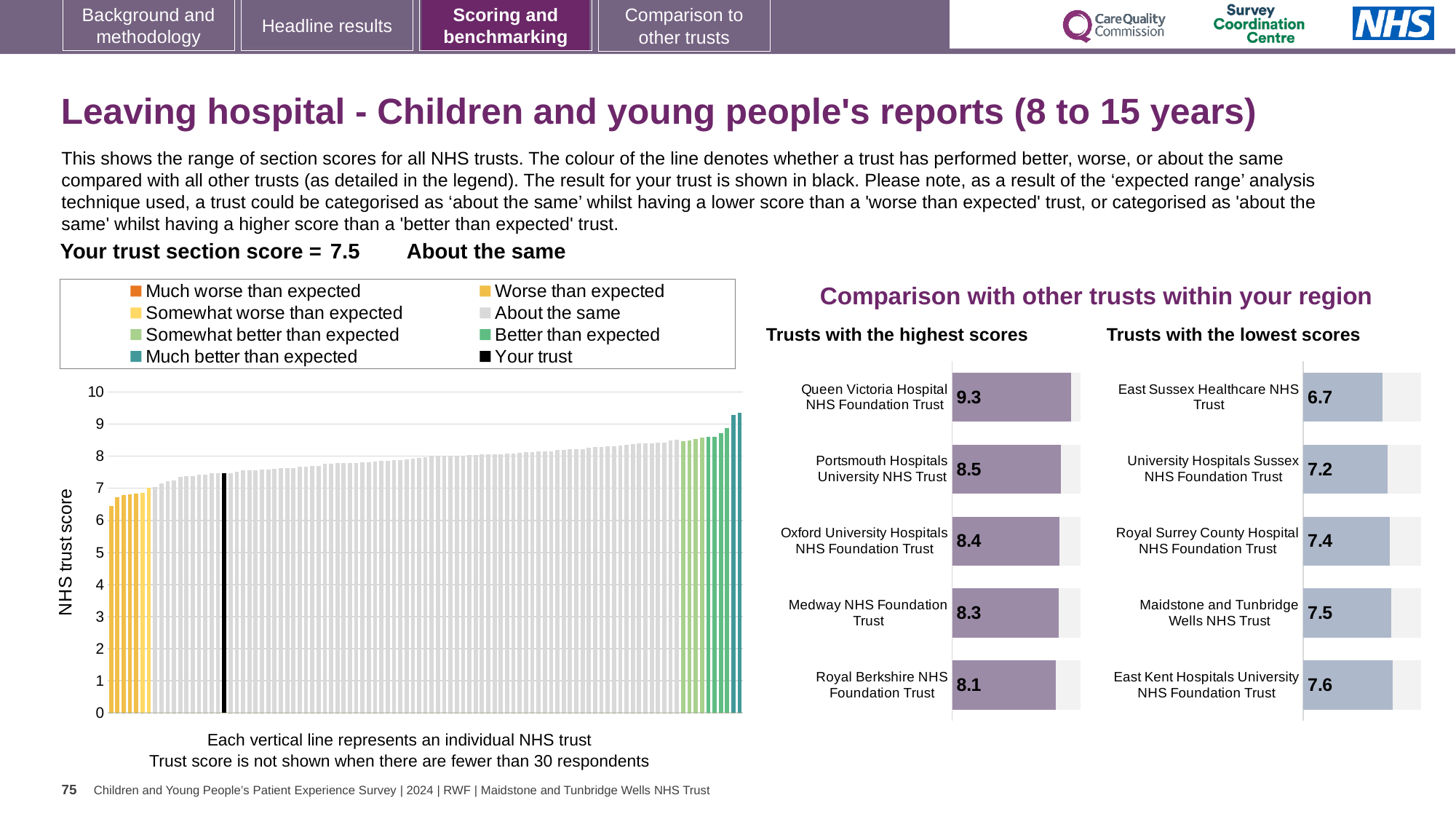
How many trusts are listed in the 'Trusts with the highest scores' chart? 5 In the 'Trusts with the lowest scores' chart, what is the difference between the scores of East Kent Hospitals University NHS Foundation Trust and East Sussex Healthcare NHS Trust? 0.9 In the NHS trust score chart on the left, is the value of the tallest bar greater or less than 9? greater In the 'Trusts with the lowest scores' chart, which trust has the lowest score? East Sussex Healthcare NHS Trust In the 'Trusts with the lowest scores' chart, which has the higher score: Royal Surrey County Hospital NHS Foundation Trust or Maidstone and Tunbridge Wells NHS Trust? Maidstone and Tunbridge Wells NHS Trust In the 'Trusts with the highest scores' chart, what is the score for Medway NHS Foundation Trust? 8.3 In the 'Trusts with the lowest scores' chart, what is the score for University Hospitals Sussex NHS Foundation Trust? 7.2 In the 'Trusts with the highest scores' chart, which trust has the highest score? Queen Victoria Hospital NHS Foundation Trust How many entries does the legend of the NHS trust score chart on the left list? 8 In the NHS trust score chart on the left, do the bar values rise or fall from left to right? rise In the 'Trusts with the highest scores' chart, what is the score for Queen Victoria Hospital NHS Foundation Trust? 9.3 In the 'Trusts with the highest scores' chart, what is the difference between the scores of Queen Victoria Hospital NHS Foundation Trust and Royal Berkshire NHS Foundation Trust? 1.2